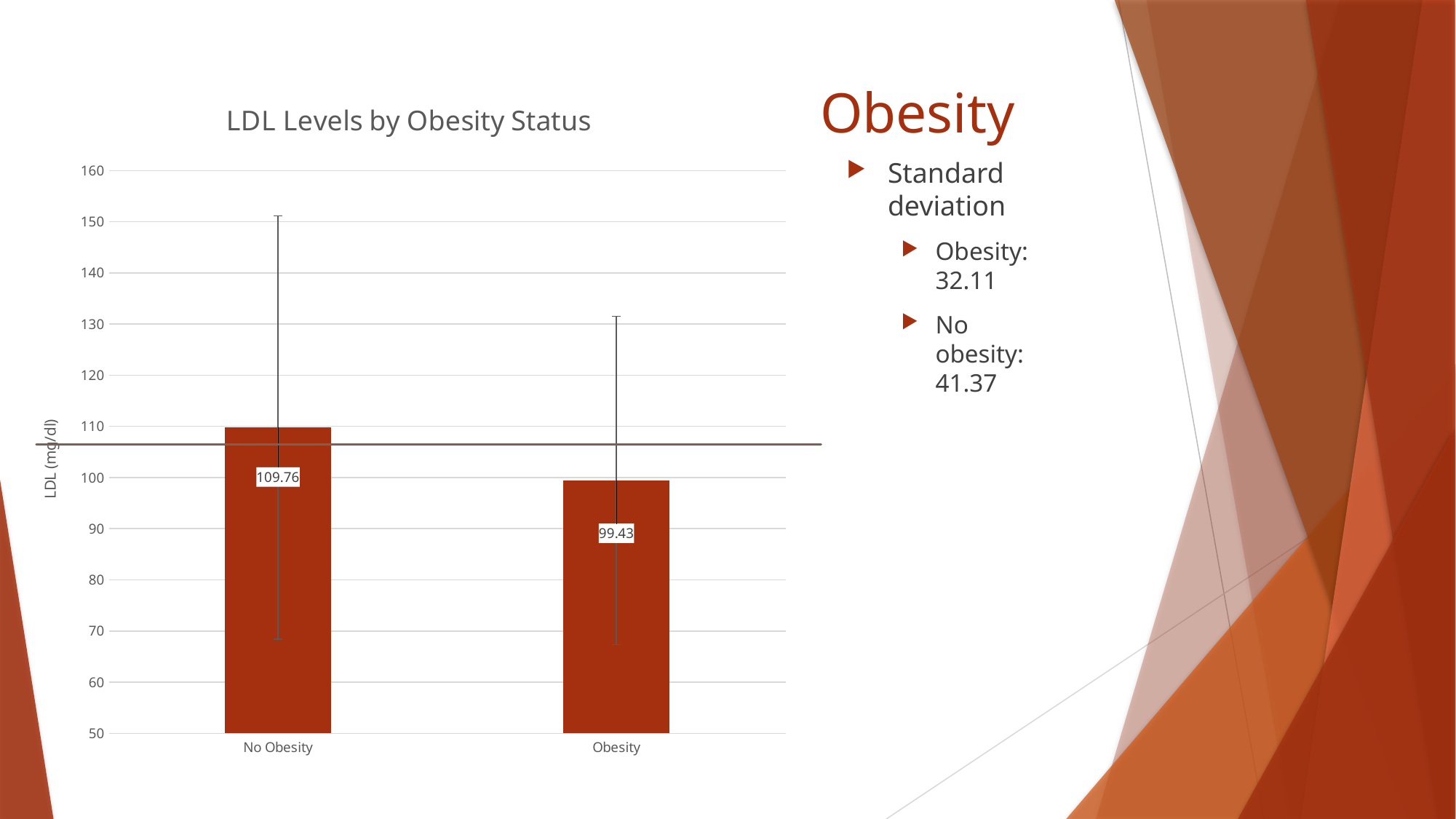
What is the LDL value for Obesity? 99.43 How many categories are shown on the x axis? 2 What kind of chart is shown on the slide? bar chart What is the LDL value for No Obesity? 109.76 What is the title of the chart? LDL Levels by Obesity Status What is the label of the y axis? LDL (mg/dl) Is the LDL value for No Obesity greater or less than 100? greater Which category has the highest LDL level? No Obesity Which is larger, the LDL value for No Obesity or for Obesity? No Obesity Which category has the lowest LDL level? Obesity Is the LDL value for Obesity greater or less than 100? less What is the difference between the LDL values for No Obesity and Obesity? 10.33